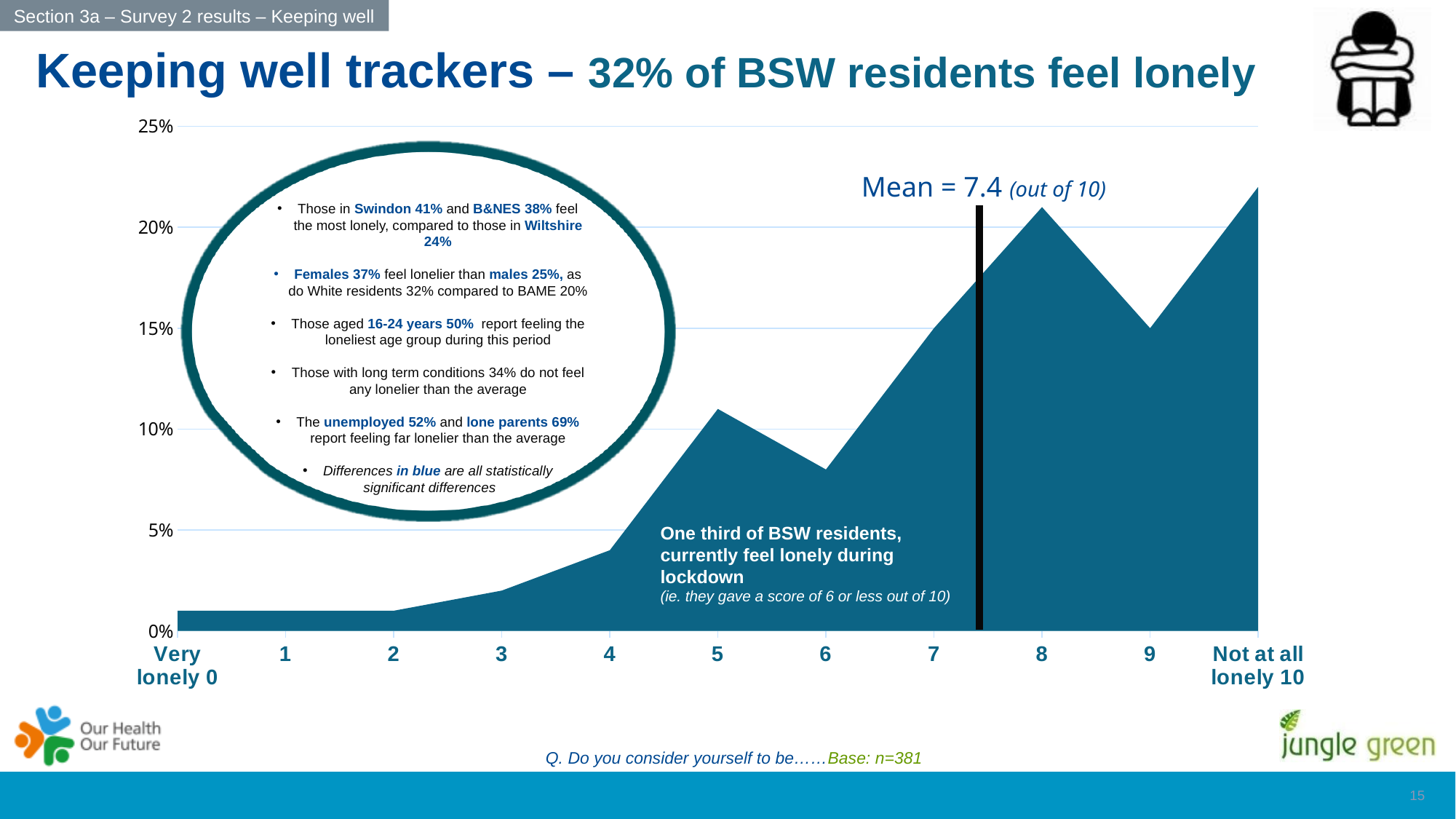
Do the values generally rise or fall moving from 'Very lonely 0' to 'Not at all lonely 10'? Rise Which has the larger value, score 8 or score 9? Score 8 What mean score is marked on the chart? 7.4 (out of 10) How many score categories are shown along the x axis of the chart? 11 What is the base size (n) stated for the chart? n=381 Is the value for score 7 greater or less than 10%? greater Which has the larger value, score 5 or score 6? Score 5 Is the value for score 6 greater or less than 10%? less Is the value for score 4 greater or less than 5%? less What kind of chart is shown on the slide? Area chart